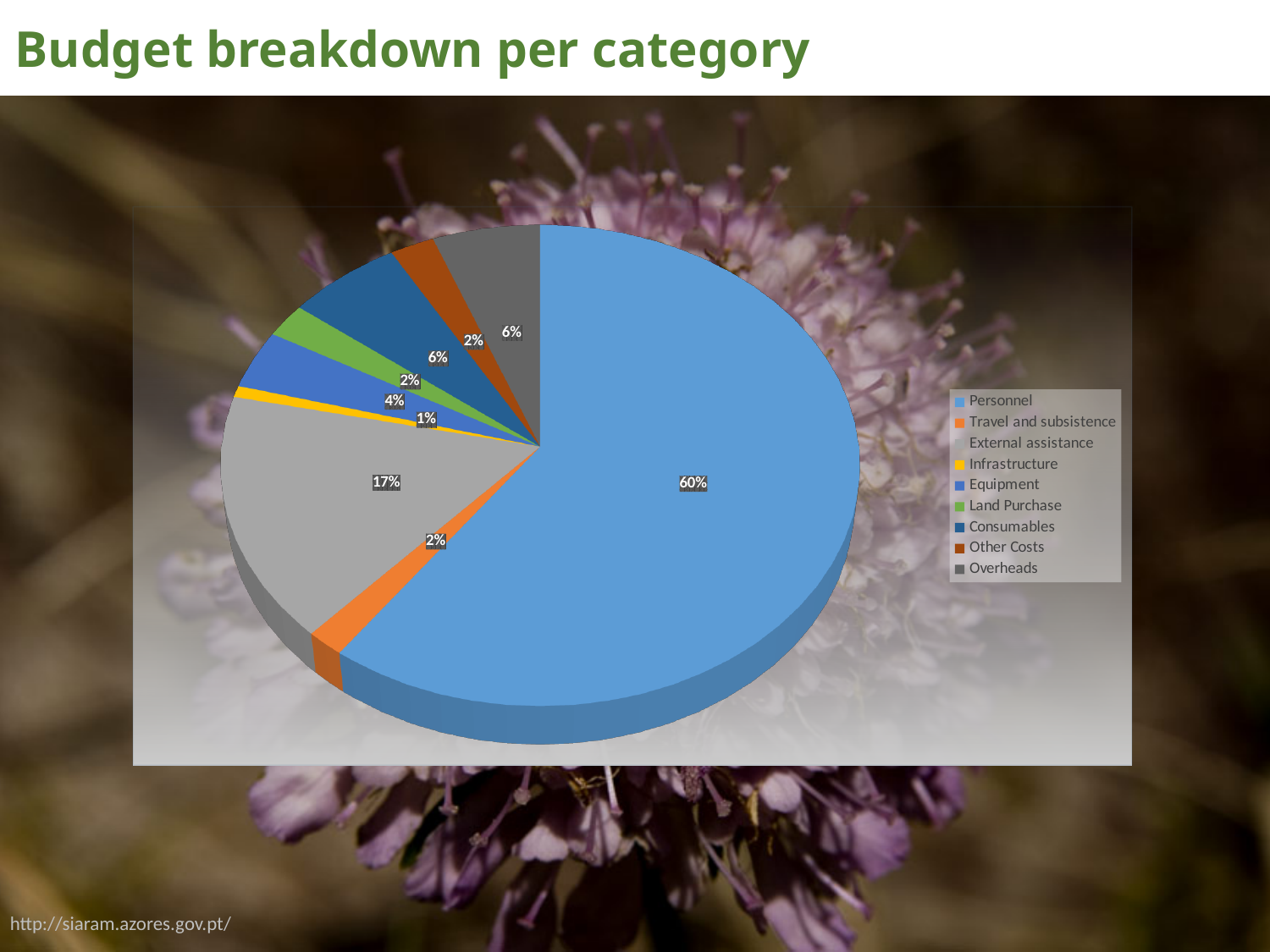
What percentage of the budget is External assistance? 17% What kind of chart is shown on the slide? pie chart What share of the budget goes to Personnel? 60% What is the difference in percentage points between Personnel and External assistance? 43 What is the title of the slide containing the chart? Budget breakdown per category Which category is shown in orange in the legend? Travel and subsistence What percentage is shown for Consumables? 6% Which category has the smallest share of the budget? Infrastructure What is the value shown for Equipment? 4% How many categories does the pie chart show? 9 Which is larger, the share for Equipment or the share for Consumables? Consumables Which category has the largest share of the budget? Personnel